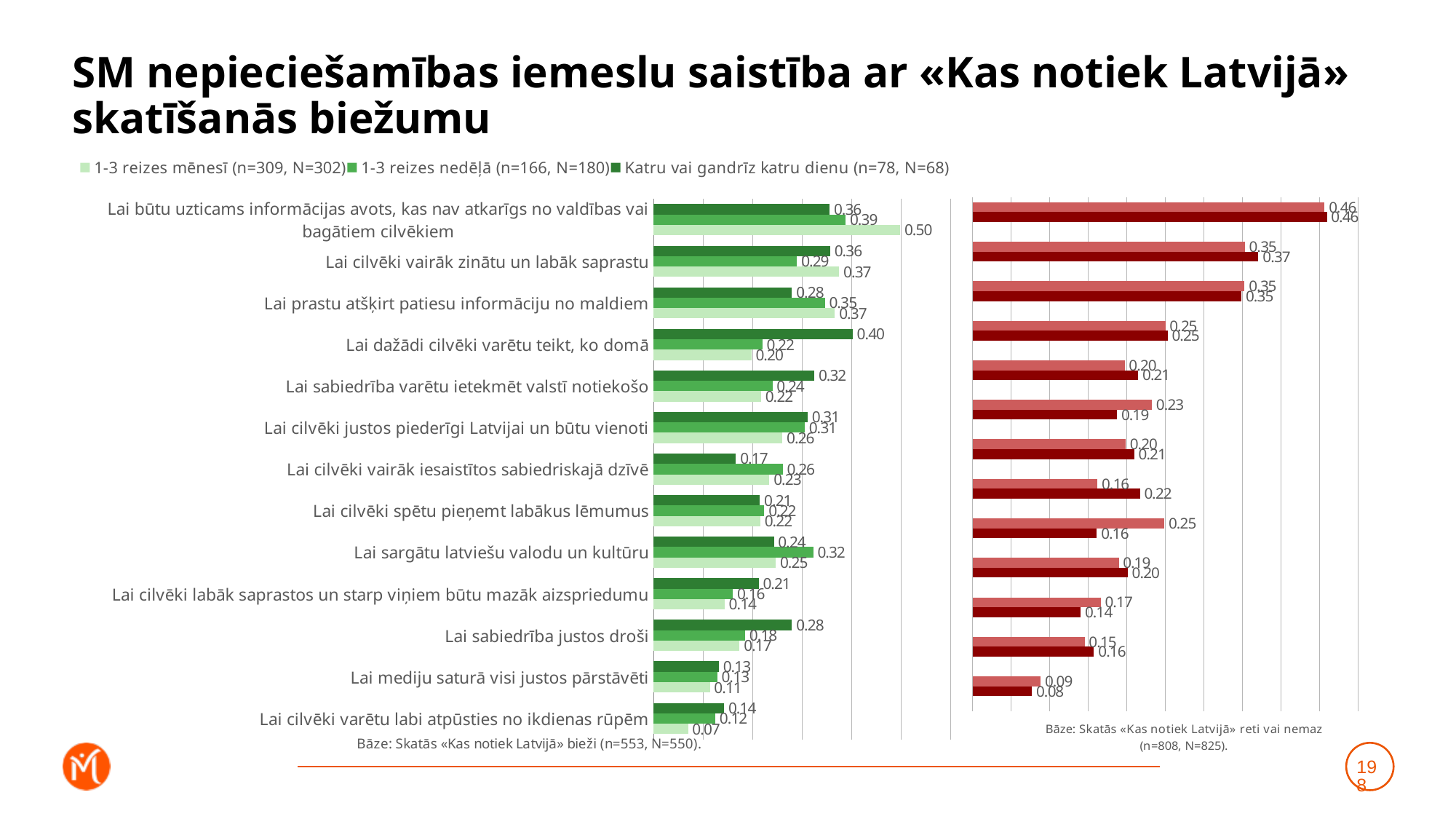
How many categories are shown in the green chart? 13 According to the legend of the green chart, what are the sample sizes for 'Katru vai gandrīz katru dienu'? n=78, N=68 In the green chart, which category has the lowest value for the '1-3 reizes mēnesī' series? Lai cilvēki varētu labi atpūsties no ikdienas rūpēm In the green chart, what is the value for 'Katru vai gandrīz katru dienu' for 'Lai dažādi cilvēki varētu teikt, ko domā'? 0.40 How many series does the legend of the green chart list? 3 In the green chart, for 'Lai sabiedrība justos droši', which series has the larger value: 'Katru vai gandrīz katru dienu' or '1-3 reizes nedēļā'? Katru vai gandrīz katru dienu In the green chart, what is the difference between the '1-3 reizes mēnesī' and 'Katru vai gandrīz katru dienu' values for 'Lai būtu uzticams informācijas avots, kas nav atkarīgs no valdības vai bagātiem cilvēkiem'? 0.14 In the red chart on the right, what is the value of the lighter red bar for the top category? 0.46 In the green chart, which category has the highest value for the '1-3 reizes mēnesī' series? Lai būtu uzticams informācijas avots, kas nav atkarīgs no valdības vai bagātiem cilvēkiem In the green chart, what is the value for '1-3 reizes mēnesī' for 'Lai būtu uzticams informācijas avots, kas nav atkarīgs no valdības vai bagātiem cilvēkiem'? 0.50 What kind of chart is the green chart on the left of the slide? Bar chart In the green chart, what is the value for '1-3 reizes nedēļā' for 'Lai sargātu latviešu valodu un kultūru'? 0.32